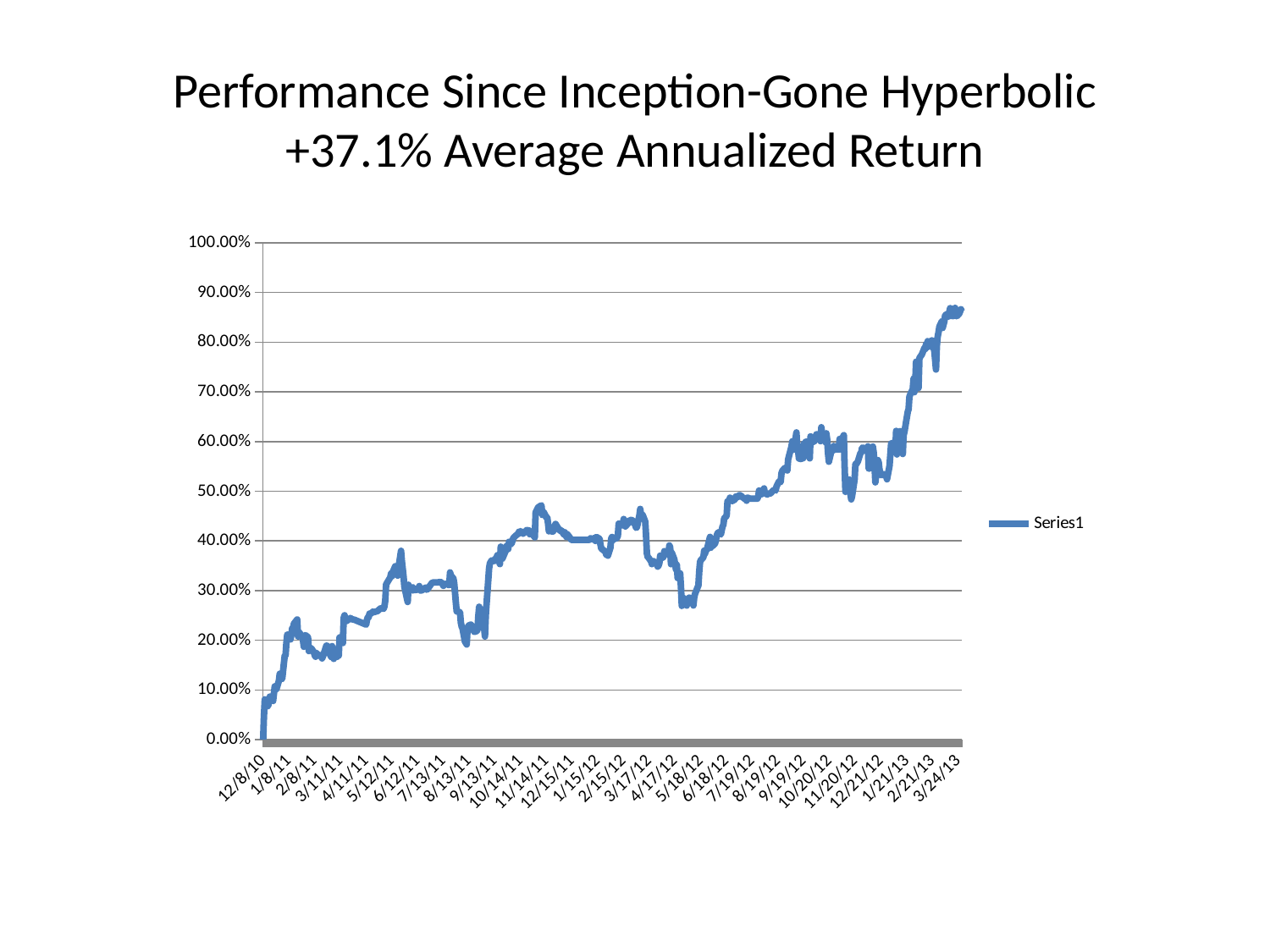
What is the highest value shown on the y axis? 100.00% What is the title of the slide containing the chart? Performance Since Inception-Gone Hyperbolic +37.1% Average Annualized Return Is the value at 12/8/10 greater or less than 10.00%? less What is the name of the series shown in the legend? Series1 Overall, do the values rise or fall from 12/8/10 to 3/24/13? rise Is the value at 8/13/11 greater or less than 40.00%? less Which of the two dates has the larger value, 3/24/13 or 12/8/10? 3/24/13 How many series does the legend list? 1 Is the value at 3/24/13 greater or less than 80.00%? greater What kind of chart is shown on the slide? line chart